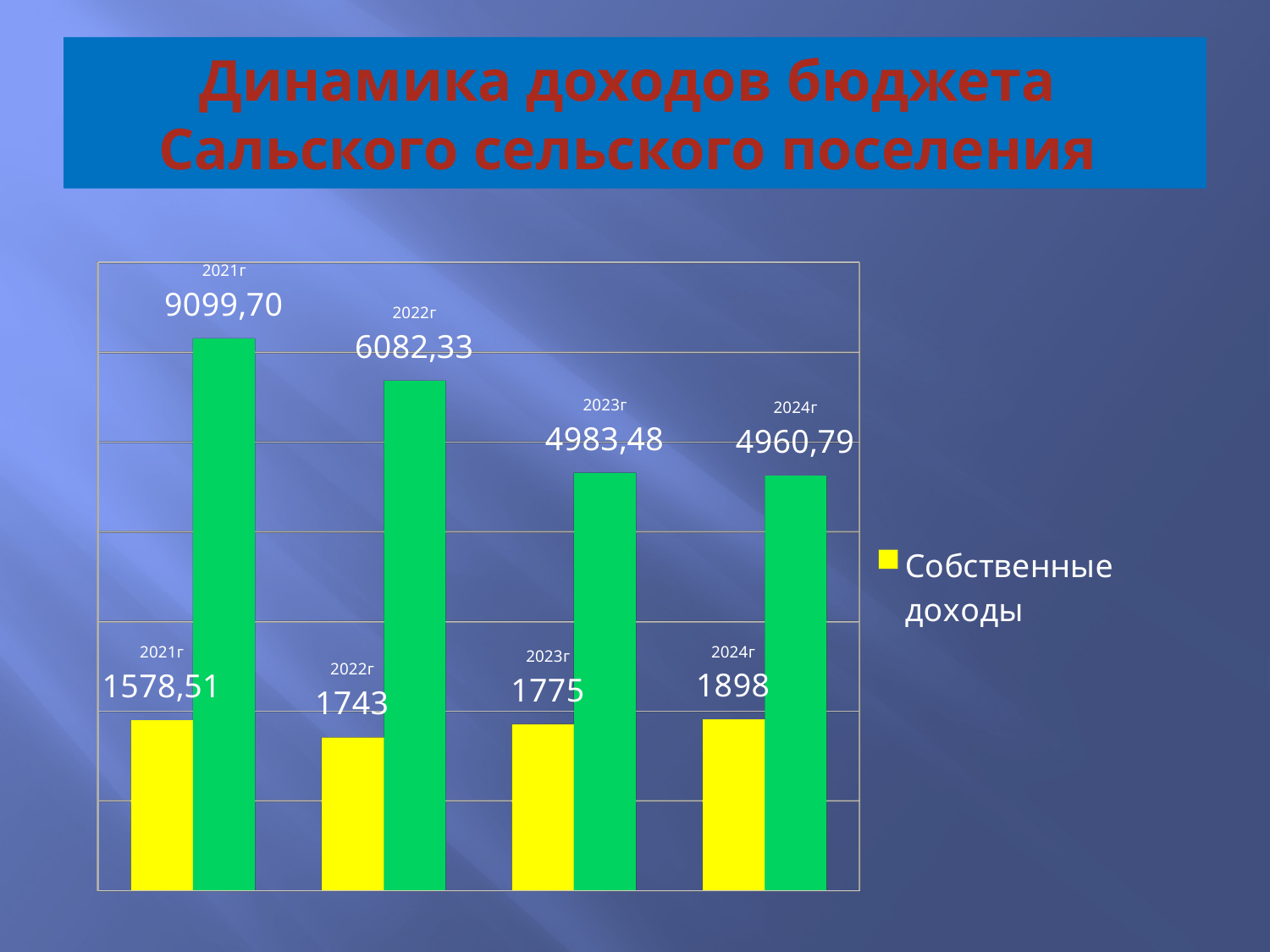
What is the value of the yellow bar (Собственные доходы) for 2021г? 1578,51 What kind of chart is shown on the slide? Bar chart Do the green bar values rise or fall from 2021г to 2024г? Fall What is the value of the yellow bar (Собственные доходы) for 2024г? 1898 Which is larger: the green bar for 2022г or the green bar for 2023г? 2022г What is the value of the green bar for 2021г? 9099,70 In which year is the green bar the highest? 2021г How many years are shown on the chart? 4 What is the difference between the yellow bar values for 2024г and 2023г? 123 What is the value of the green bar for 2023г? 4983,48 What is the difference between the green bar values for 2021г and 2022г? 3017,37